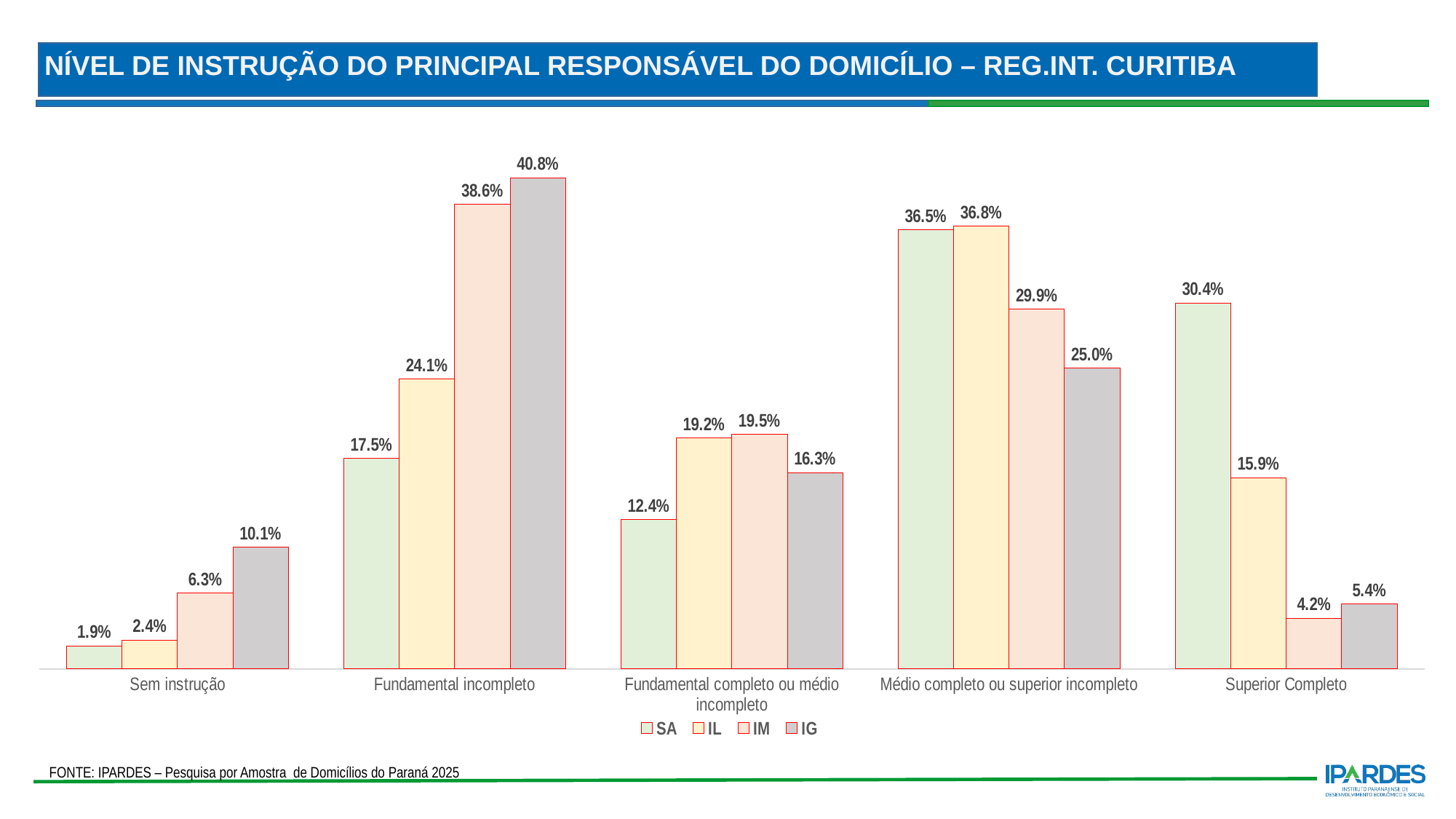
Which category has the lowest value for the IG series? Superior Completo Does the SA series rise or fall from 'Sem instrução' to 'Médio completo ou superior incompleto'? Rise What is the value for SA in the 'Superior Completo' category? 30.4% How many series does the legend list? 4 How many categories are shown on the x axis? 5 What is the source cited at the bottom of the slide? IPARDES – Pesquisa por Amostra de Domicílios do Paraná 2025 Which is larger in the 'Superior Completo' category: the IL value or the IM value? IL What is the difference between the IG and SA values in the 'Fundamental incompleto' category? 23.3% Which category has the highest value for the SA series? Médio completo ou superior incompleto What is the value for IM in the 'Sem instrução' category? 6.3% What is the value for IG in the 'Fundamental incompleto' category? 40.8% What kind of chart is shown on the slide? Bar chart